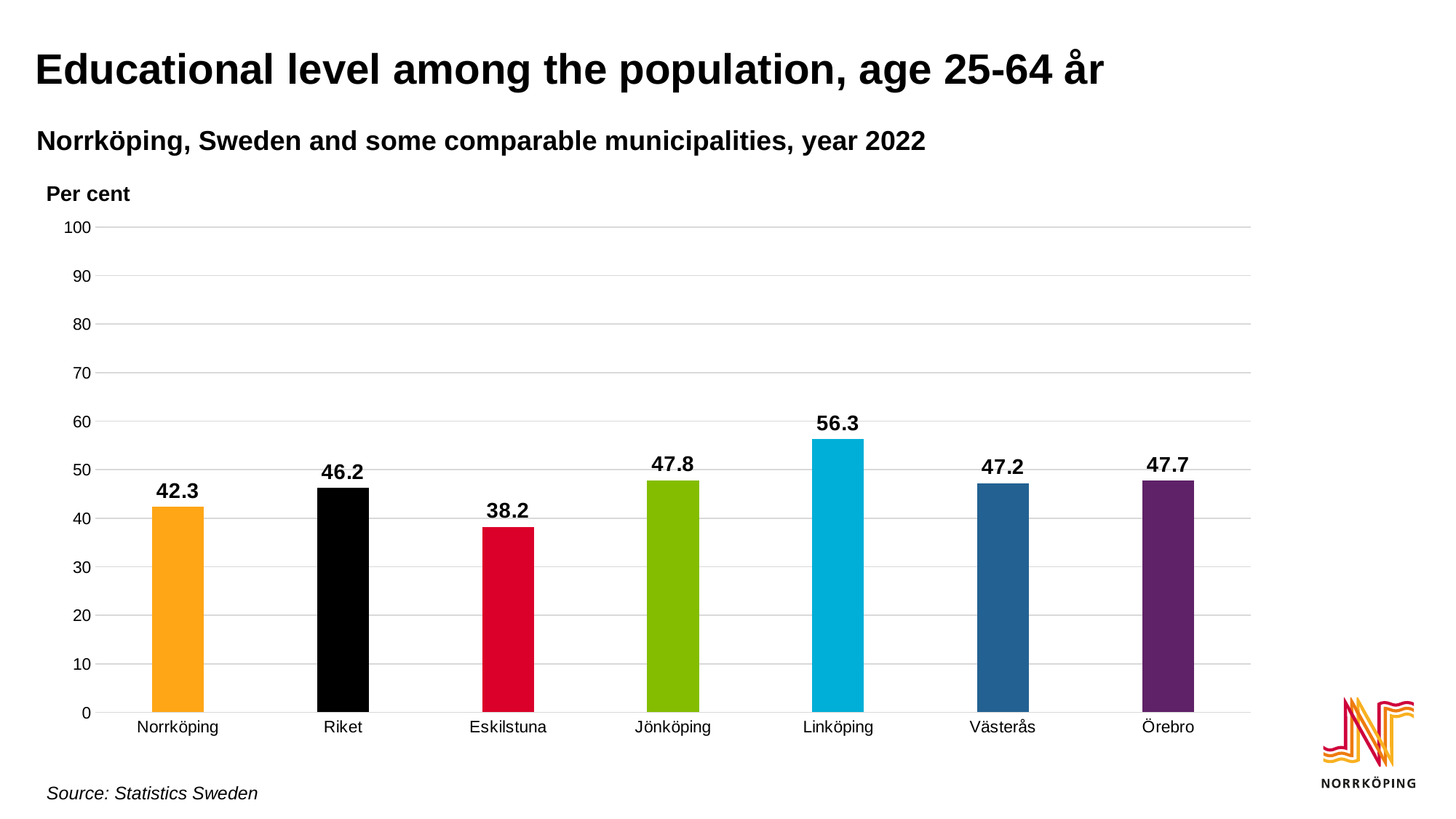
Is the value for Linköping greater or less than 50? greater Which municipality has the highest value? Linköping What is the value for Linköping? 56.3 What is the value for Eskilstuna? 38.2 What is the difference between the values for Riket and Eskilstuna? 8 Which is larger, the value for Jönköping or the value for Norrköping? Jönköping What is the difference between the values for Linköping and Norrköping? 14 What unit is shown on the y axis label? Per cent What kind of chart is shown on the slide? bar chart How many municipalities/categories are shown on the x axis? 7 Which municipality has the lowest value? Eskilstuna What is the value for Norrköping? 42.3